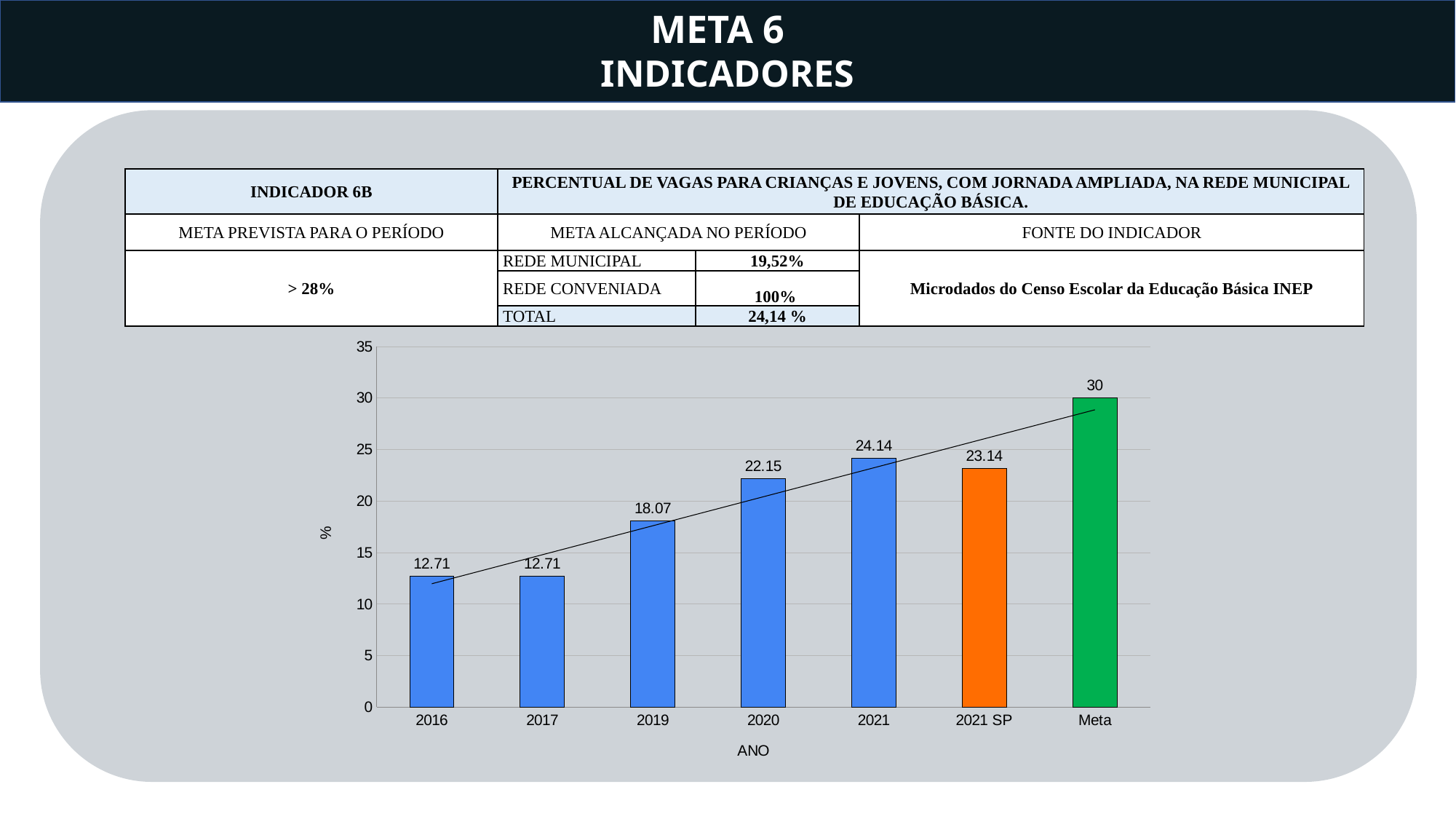
How many bars are shown in the bar chart? 7 What is the value for 2019 in the bar chart? 18.07 What is the label of the x axis of the bar chart? ANO What is the value for 2021 SP in the bar chart? 23.14 Do the values rise or fall from 2016 to 2021 in the bar chart? rise Which category has the highest value in the bar chart? Meta What is the value for Meta in the bar chart? 30 What kind of chart is shown on the slide? bar chart Which is larger in the bar chart, the value for 2021 or the value for 2021 SP? 2021 Is the value for 2020 in the bar chart greater or less than 20? greater What is the difference between the values for 2021 and 2020 in the bar chart? 1.99 What is the difference between the Meta value and the 2021 value in the bar chart? 5.86